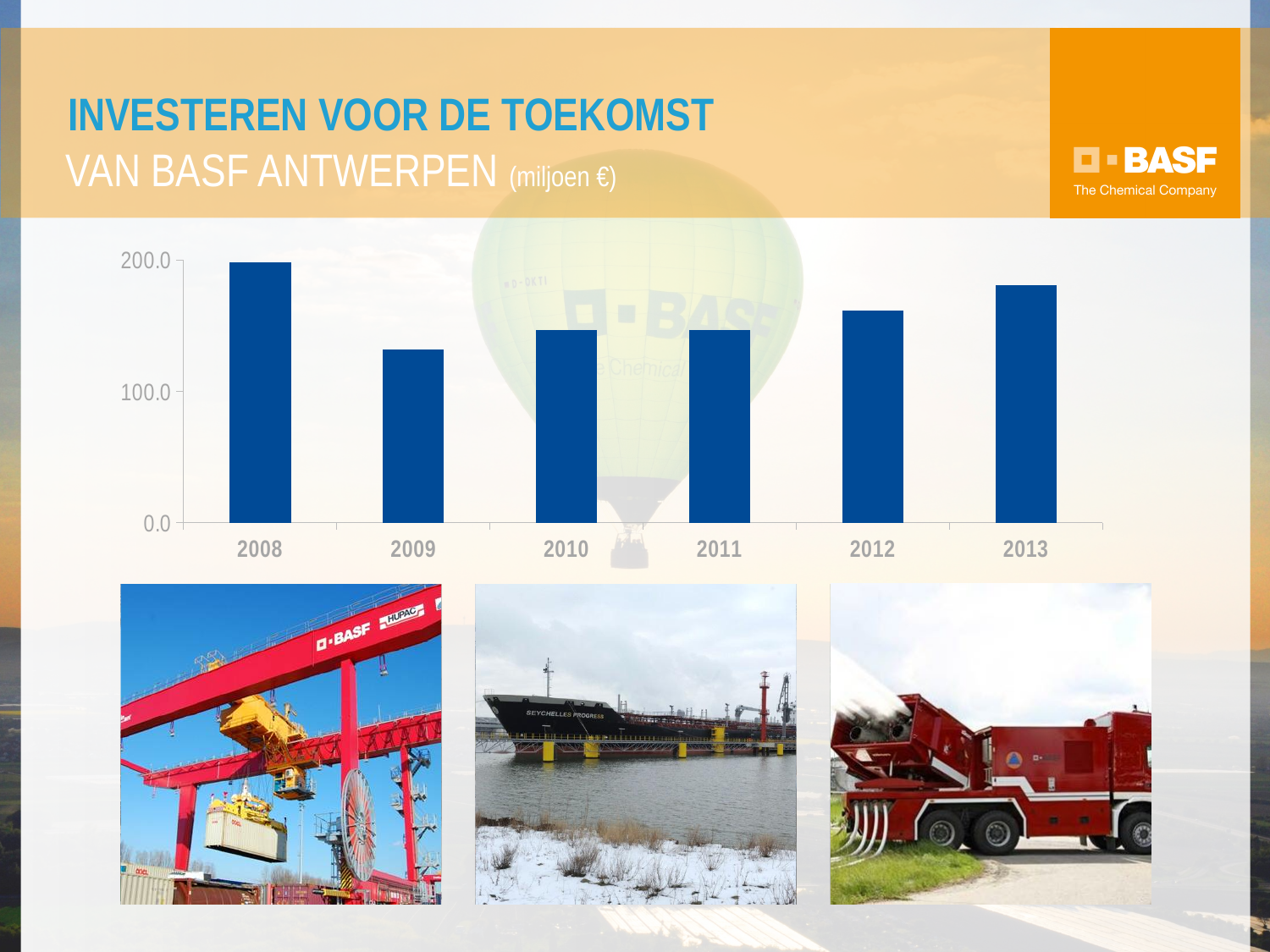
Which is larger, the value for 2012 or the value for 2013? 2013 How many years are shown on the x axis of the chart? 6 Is the value for 2009 greater or less than 100.0? greater What kind of chart is shown on the slide? bar chart Is the value for 2013 greater or less than 200.0? less Do the values rise or fall from 2009 to 2013? rise Is the value for 2012 greater or less than 100.0? greater In what unit are the values in the chart expressed, according to the slide title? miljoen € Which year has the lowest bar in the chart? 2009 Which is larger, the value for 2009 or the value for 2012? 2012 Which is larger, the value for 2008 or the value for 2009? 2008 Which year has the highest bar in the chart? 2008